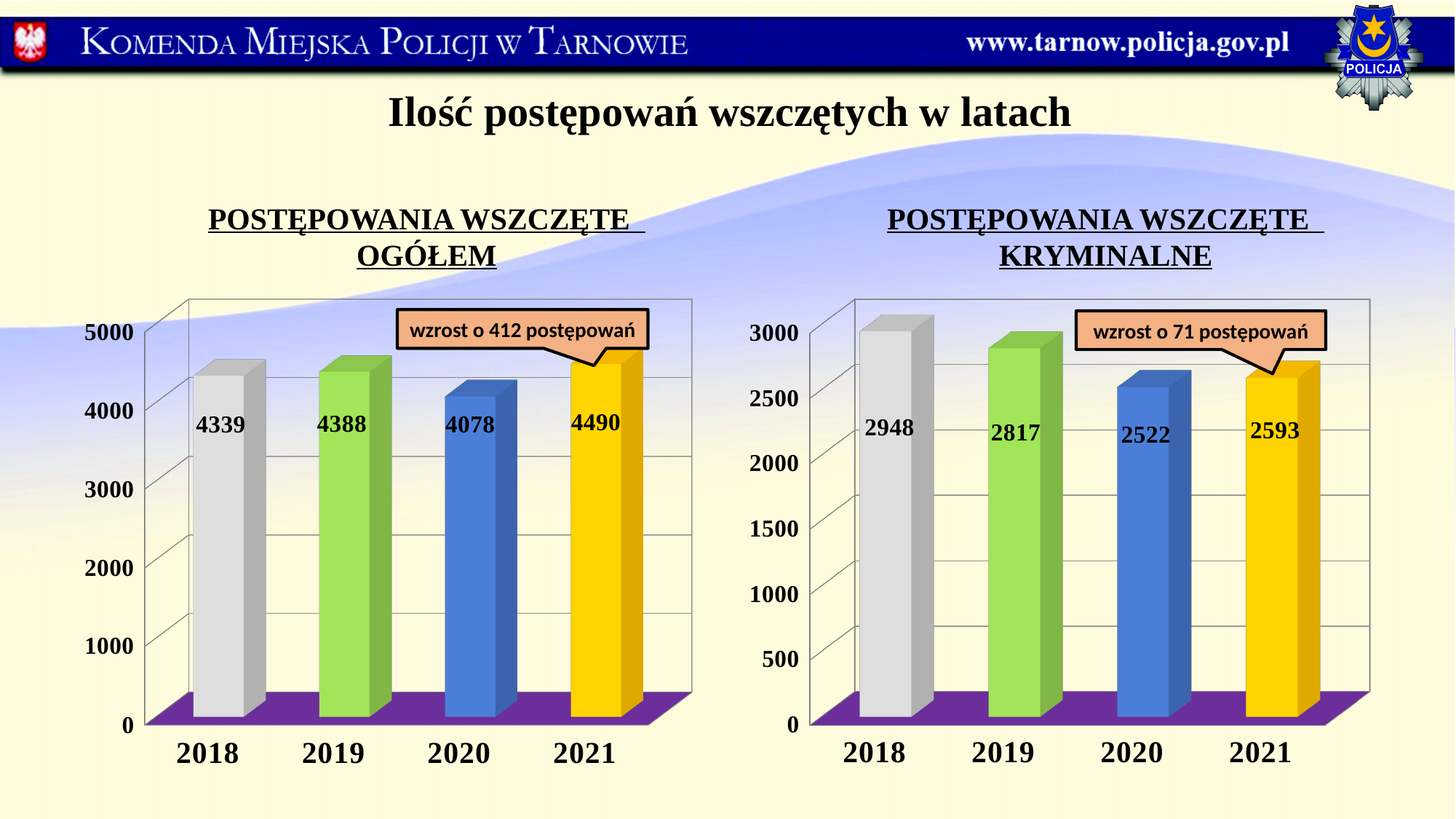
In the 'POSTĘPOWANIA WSZCZĘTE OGÓŁEM' chart, what is the difference between the 2021 and 2020 values? 412 What does the callout on the 'POSTĘPOWANIA WSZCZĘTE KRYMINALNE' chart say? wzrost o 71 postępowań In the 'POSTĘPOWANIA WSZCZĘTE KRYMINALNE' chart, what is the value for 2019? 2817 In the 'POSTĘPOWANIA WSZCZĘTE KRYMINALNE' chart, is the value for 2020 greater or less than 2500? greater In the 'POSTĘPOWANIA WSZCZĘTE KRYMINALNE' chart, do the values rise or fall from 2018 to 2020? fall In the 'POSTĘPOWANIA WSZCZĘTE OGÓŁEM' chart, what is the value for 2021? 4490 In the 'POSTĘPOWANIA WSZCZĘTE KRYMINALNE' chart, what is the difference between the 2018 and 2020 values? 426 What kind of chart is the 'POSTĘPOWANIA WSZCZĘTE KRYMINALNE' chart? bar chart In the 'POSTĘPOWANIA WSZCZĘTE OGÓŁEM' chart, which is larger, the value for 2018 or 2019? 2019 How many years are shown in the 'POSTĘPOWANIA WSZCZĘTE OGÓŁEM' chart? 4 In the 'POSTĘPOWANIA WSZCZĘTE KRYMINALNE' chart, which year has the highest value? 2018 In the 'POSTĘPOWANIA WSZCZĘTE OGÓŁEM' chart, which year has the lowest value? 2020